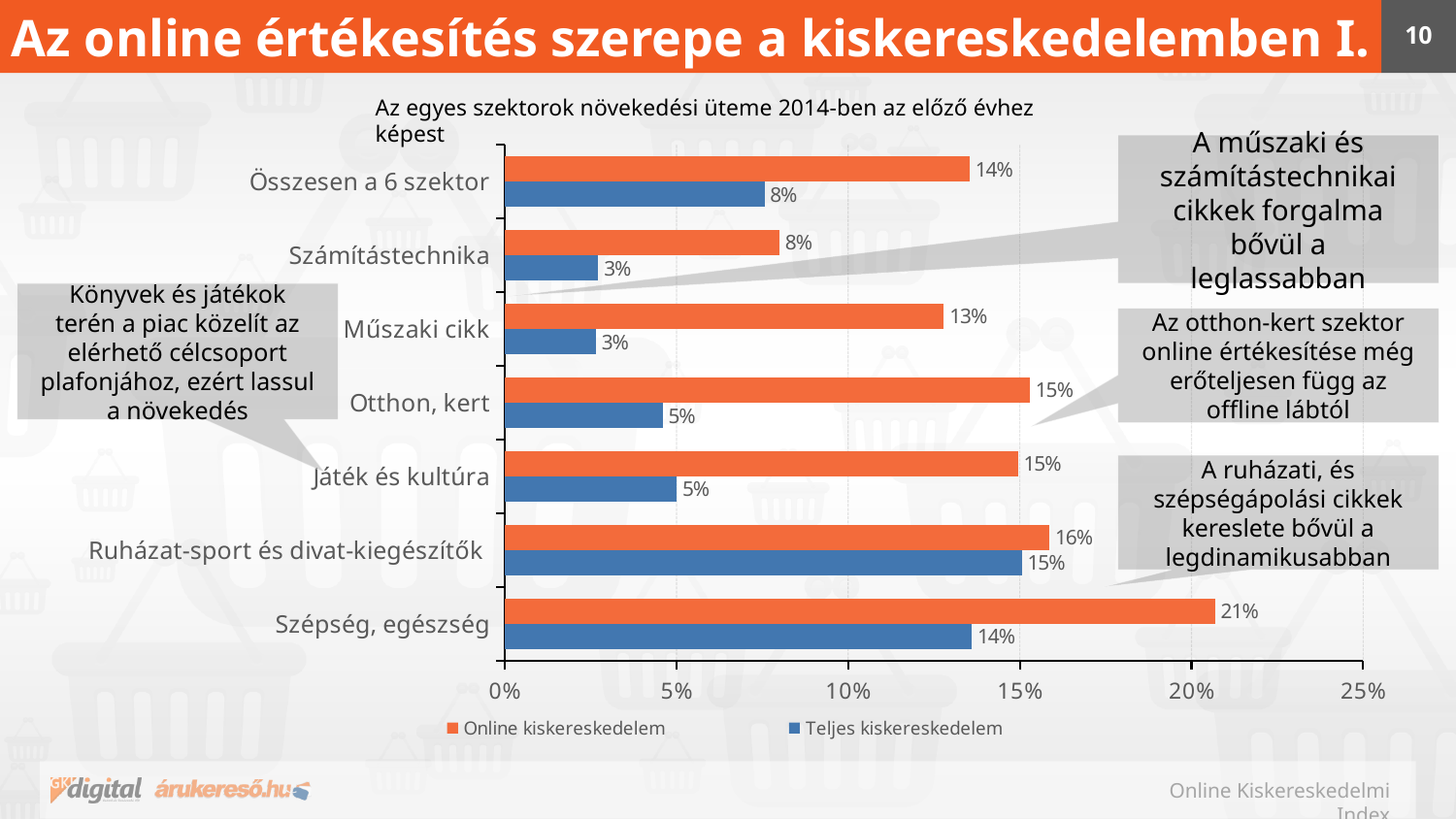
Which is larger for Ruházat-sport és divat-kiegészítők: the Online kiskereskedelem value or the Teljes kiskereskedelem value? Online kiskereskedelem How many categories are shown on the chart? 7 What is the Teljes kiskereskedelem value for Műszaki cikk? 3% What is the difference between the Online kiskereskedelem and Teljes kiskereskedelem values for Otthon, kert? 10% Which colour represents Teljes kiskereskedelem in the chart? Blue How many series does the legend list? 2 Which category has the highest Online kiskereskedelem value? Szépség, egészség What is the Online kiskereskedelem value for Szépség, egészség? 21% Which category has the lowest Online kiskereskedelem value? Számítástechnika Is the Teljes kiskereskedelem value for Szépség, egészség greater or less than 10%? greater What is the Online kiskereskedelem value for Összesen a 6 szektor? 14% What kind of chart is shown on the slide? Bar chart